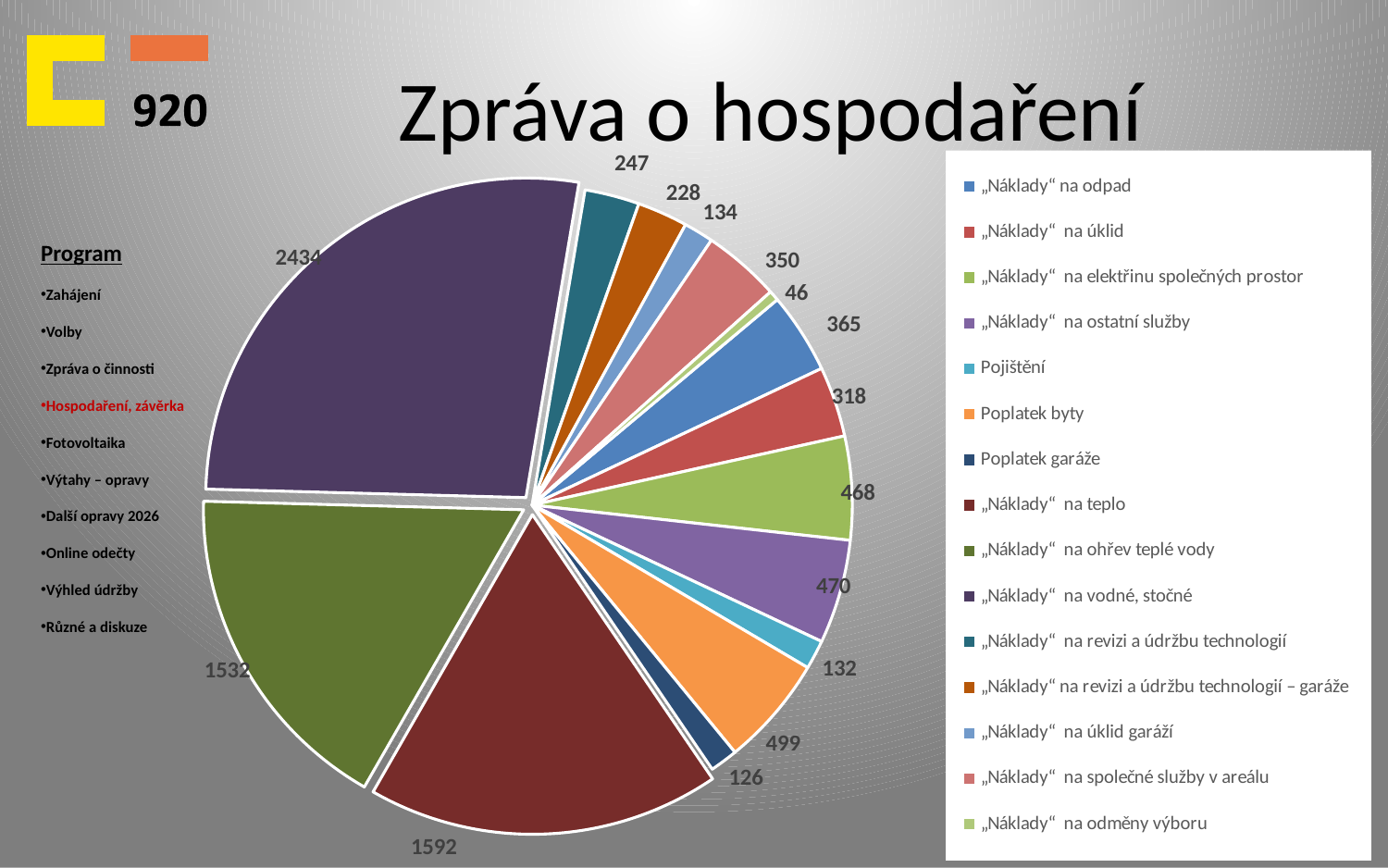
What kind of chart is shown on the slide? pie chart Which category has the largest slice in the pie chart? „Náklady“ na vodné, stočné Which category has the smallest slice in the pie chart? „Náklady“ na odměny výboru What is the value shown for Poplatek byty? 499 How many slices does the pie chart have? 15 What is the difference between the values for „Náklady“ na teplo and „Náklady“ na ohřev teplé vody? 60 Which is larger, the value for „Náklady“ na odpad or the value for „Náklady“ na úklid? „Náklady“ na odpad How many entries does the chart legend list? 15 What is the value shown for „Náklady“ na teplo? 1592 What is the value shown for Pojištění? 132 What is the value shown for „Náklady“ na revizi a údržbu technologií – garáže? 228 What is the title of the chart on the slide? Zpráva o hospodaření